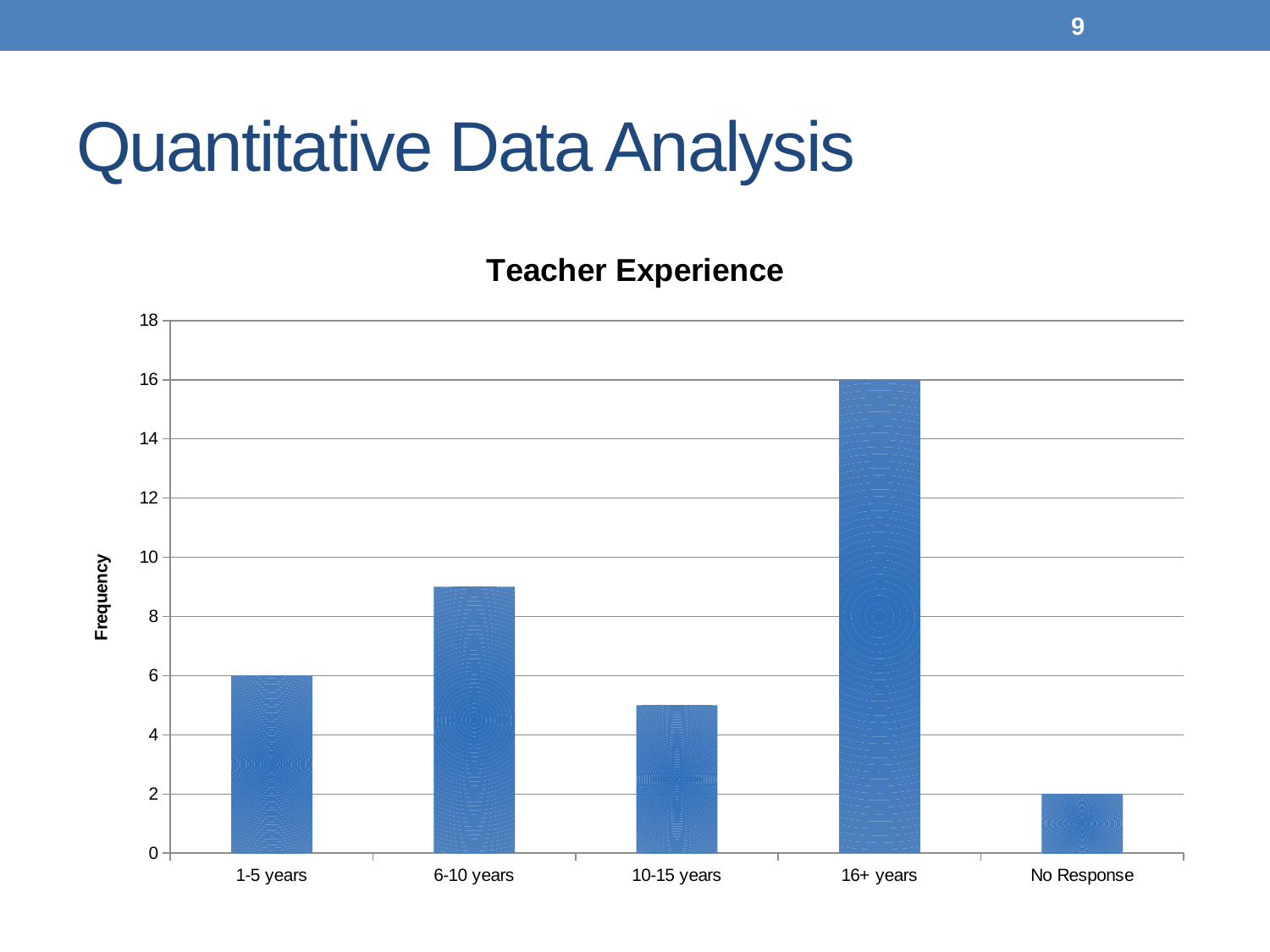
What is the difference in frequency between 16+ years and 1-5 years? 10 Which category has the highest frequency? 16+ years What is the label on the vertical axis of the chart? Frequency What is the frequency for 16+ years? 16 Which has a higher frequency, 6-10 years or 10-15 years? 6-10 years What is the frequency for 1-5 years? 6 How many categories are shown on the x axis of the chart? 5 What is the frequency for No Response? 2 What type of chart is shown on the slide? bar chart What is the title of the chart? Teacher Experience Is the frequency for 6-10 years greater or less than 8? greater Which category has the lowest frequency? No Response